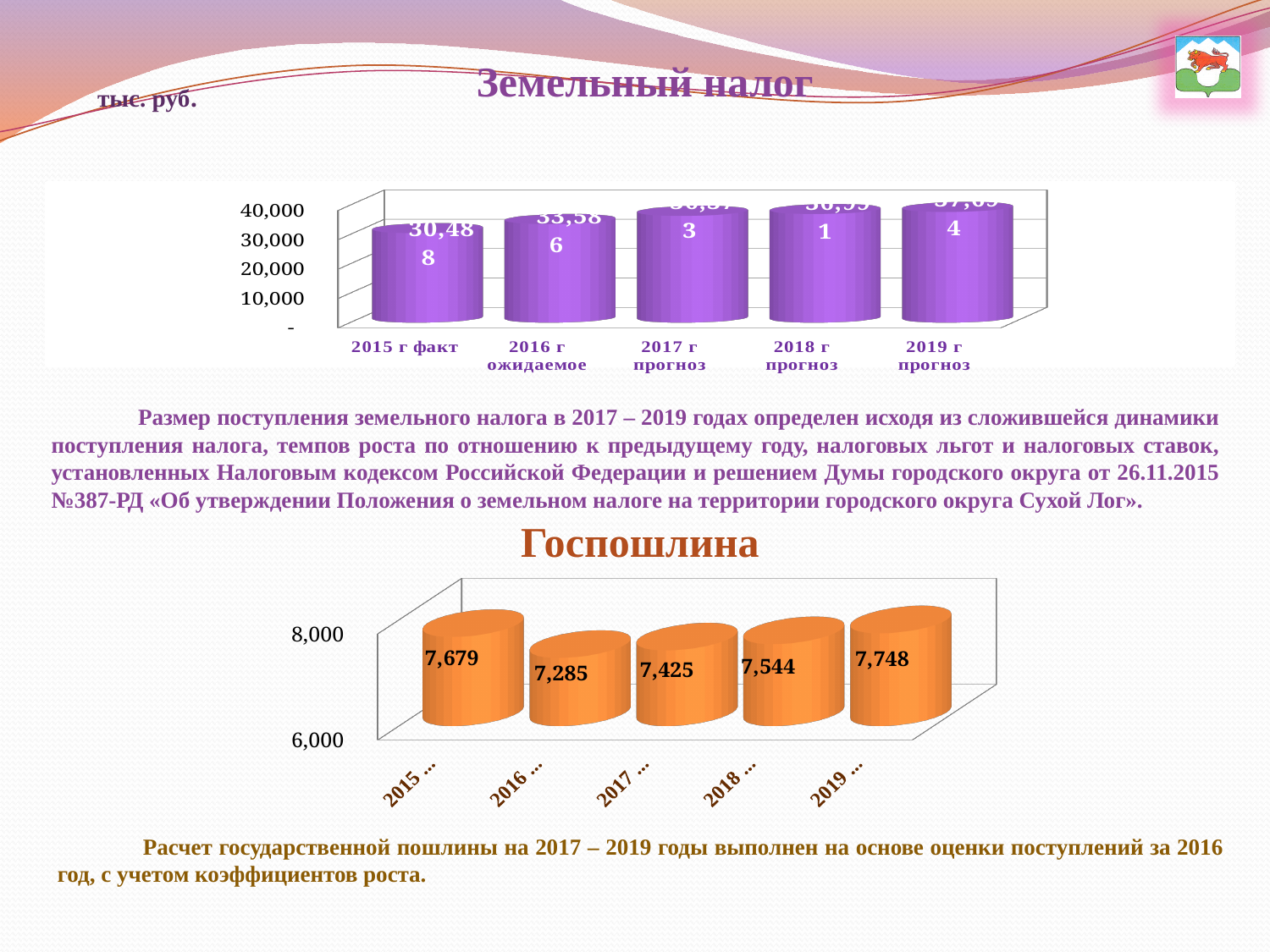
In the Земельный налог chart, what is the value for 2016 г ожидаемое? 33,586 How many categories are shown in the Земельный налог chart? 5 In the Земельный налог chart, is the value for 2019 г прогноз greater or less than 30,000? greater In the Госпошлина chart, which is larger, the value for 2018 or the value for 2017? 2018 What kind of chart is the Земельный налог chart? bar chart In the Земельный налог chart, do the values rise or fall from 2015 to 2019? rise In the Госпошлина chart, which year has the highest value? 2019 In the Земельный налог chart, what is the value for 2015 г факт? 30,488 In the Госпошлина chart, which year has the lowest value? 2016 In the Госпошлина chart, what is the difference between the 2019 value and the 2015 value? 69 In the Госпошлина chart, what is the value for 2017? 7,425 In the Земельный налог chart, what is the difference between the 2016 г ожидаемое value and the 2015 г факт value? 3,098